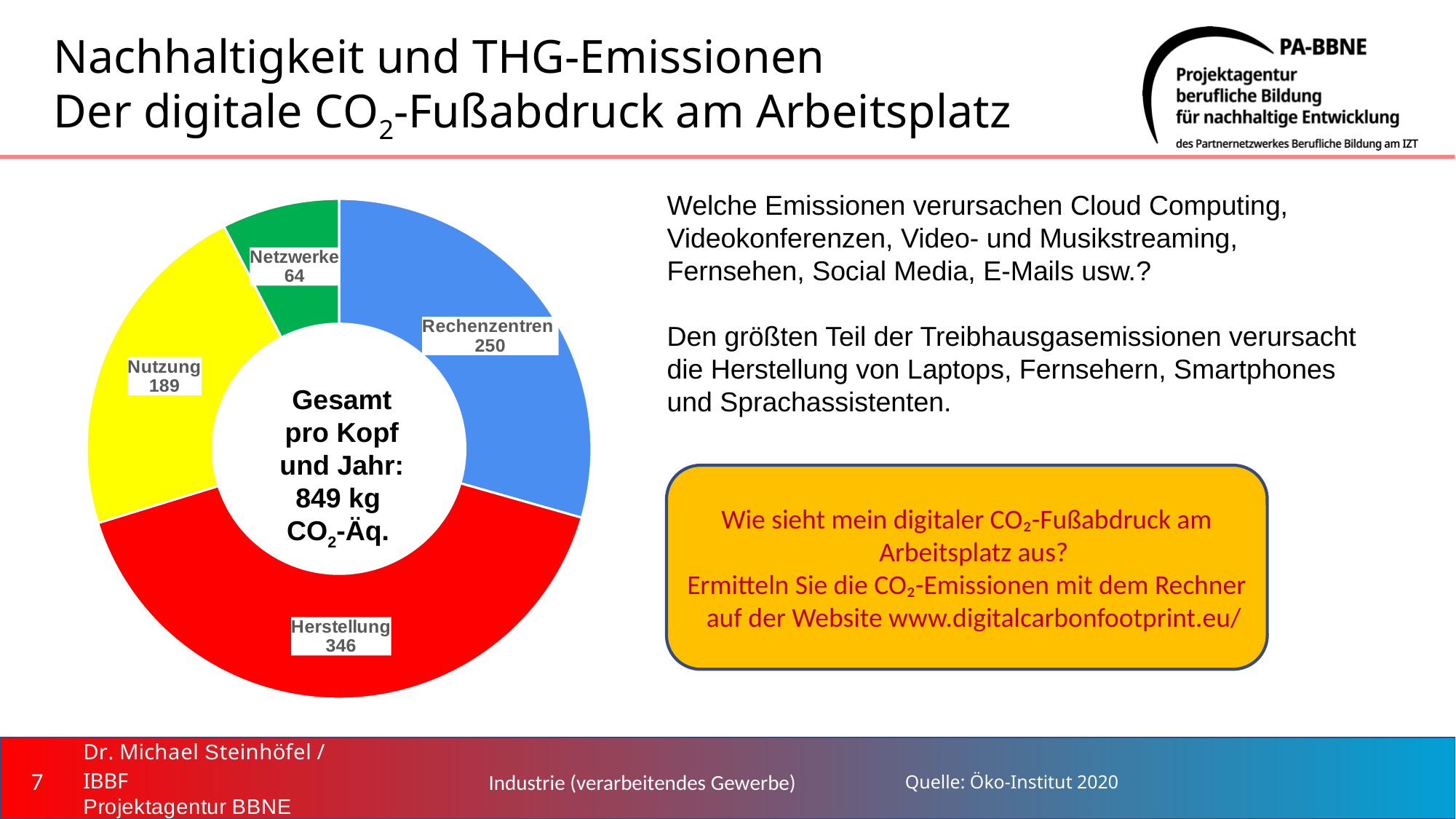
What is the difference between the values for Herstellung and Rechenzentren? 96 How many categories does the chart show? 4 What is the difference between the values for Nutzung and Netzwerke? 125 What total is printed in the centre of the chart? 849 kg CO2-Äq. What value is shown for Nutzung in the chart? 189 What kind of chart is shown on the slide? Doughnut (pie) chart Which category has the largest value in the chart? Herstellung What value is shown for Netzwerke in the chart? 64 Which is larger, the value for Rechenzentren or the value for Nutzung? Rechenzentren What value is shown for Herstellung in the doughnut chart? 346 What value is shown for Rechenzentren in the chart? 250 Which category has the smallest value in the chart? Netzwerke